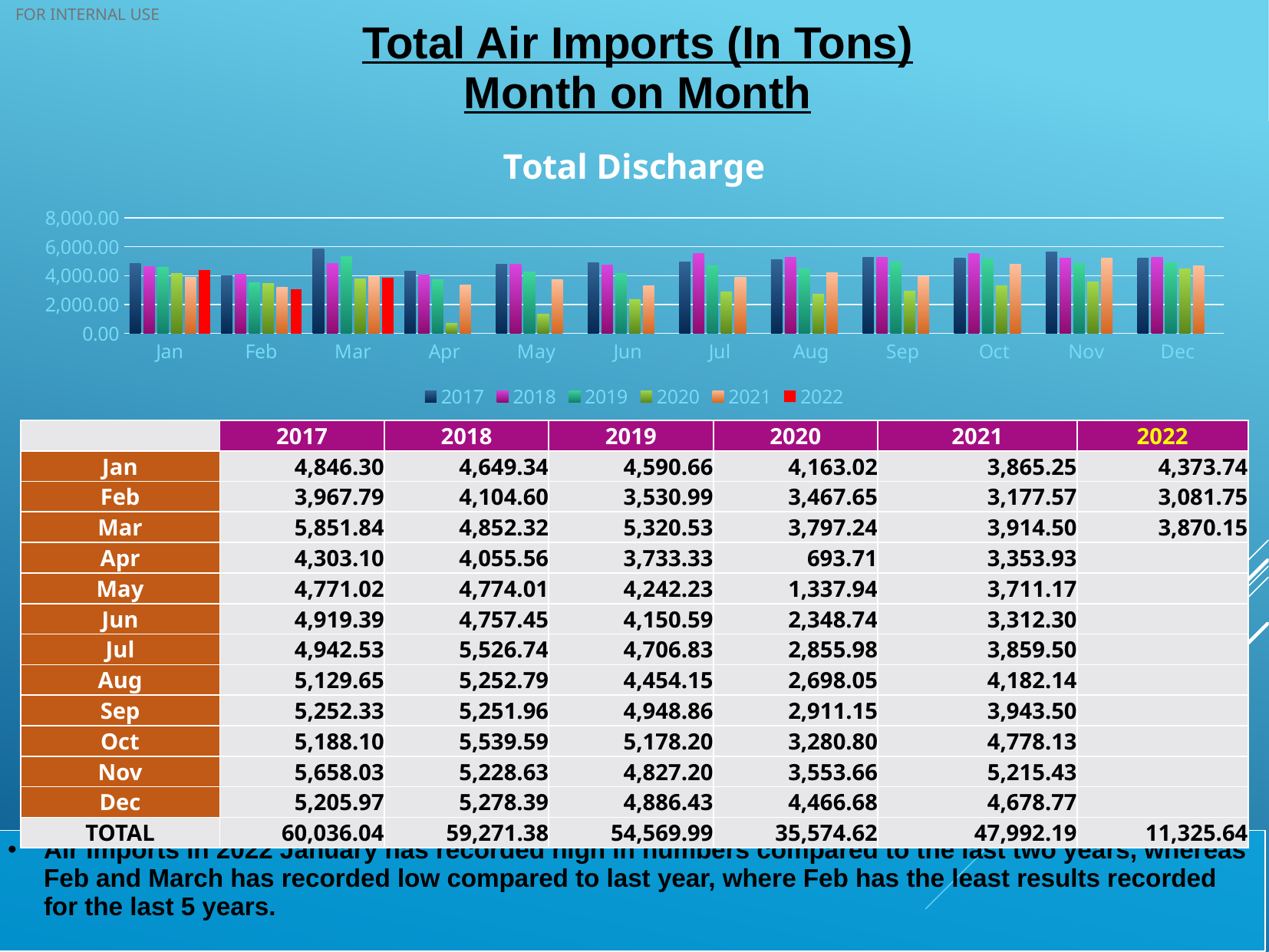
How many months are shown along the x axis of the chart? 12 Which month has the lowest value for 2020? Apr What is the title of the chart? Total Discharge How many series does the chart legend list? 6 What kind of chart is shown on the slide? bar chart Which is larger in Mar, the value for 2017 or the value for 2019? 2017 What is the value for 2020 in Apr? 693.71 Which month has the highest value for 2017? Mar What is the value for 2022 in Jan? 4,373.74 What is the difference between the Jan values for 2017 and 2022? 472.56 Is the value for 2020 in Apr greater or less than 2,000.00? less Do the 2020 values rise or fall from Apr to Jul? rise